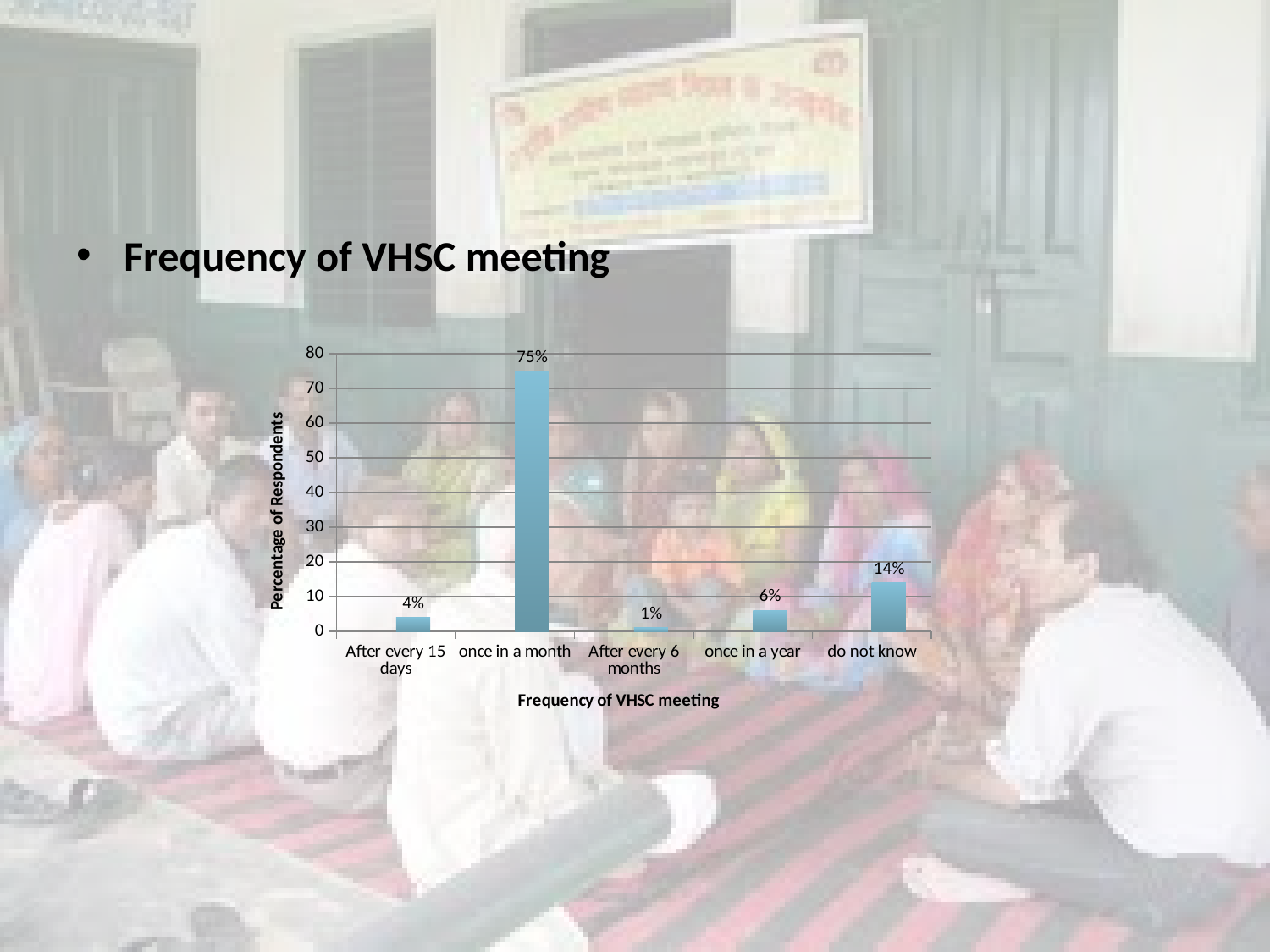
Which has a larger percentage of respondents: 'once in a year' or 'After every 15 days'? once in a year What percentage of respondents said VHSC meetings are held once in a year? 6% What is the difference in percentage points between 'once in a month' and 'do not know'? 61 Which meeting frequency category has the lowest percentage of respondents? After every 6 months What is the label of the vertical axis of the chart? Percentage of Respondents What percentage of respondents answered 'do not know' about the frequency of VHSC meetings? 14% Which meeting frequency category has the highest percentage of respondents? once in a month What percentage of respondents said VHSC meetings are held after every 15 days? 4% What kind of chart is shown on the slide? bar chart What percentage of respondents said VHSC meetings are held once in a month? 75% Is the value for 'do not know' greater or less than 10? greater How many meeting frequency categories are shown on the x axis? 5